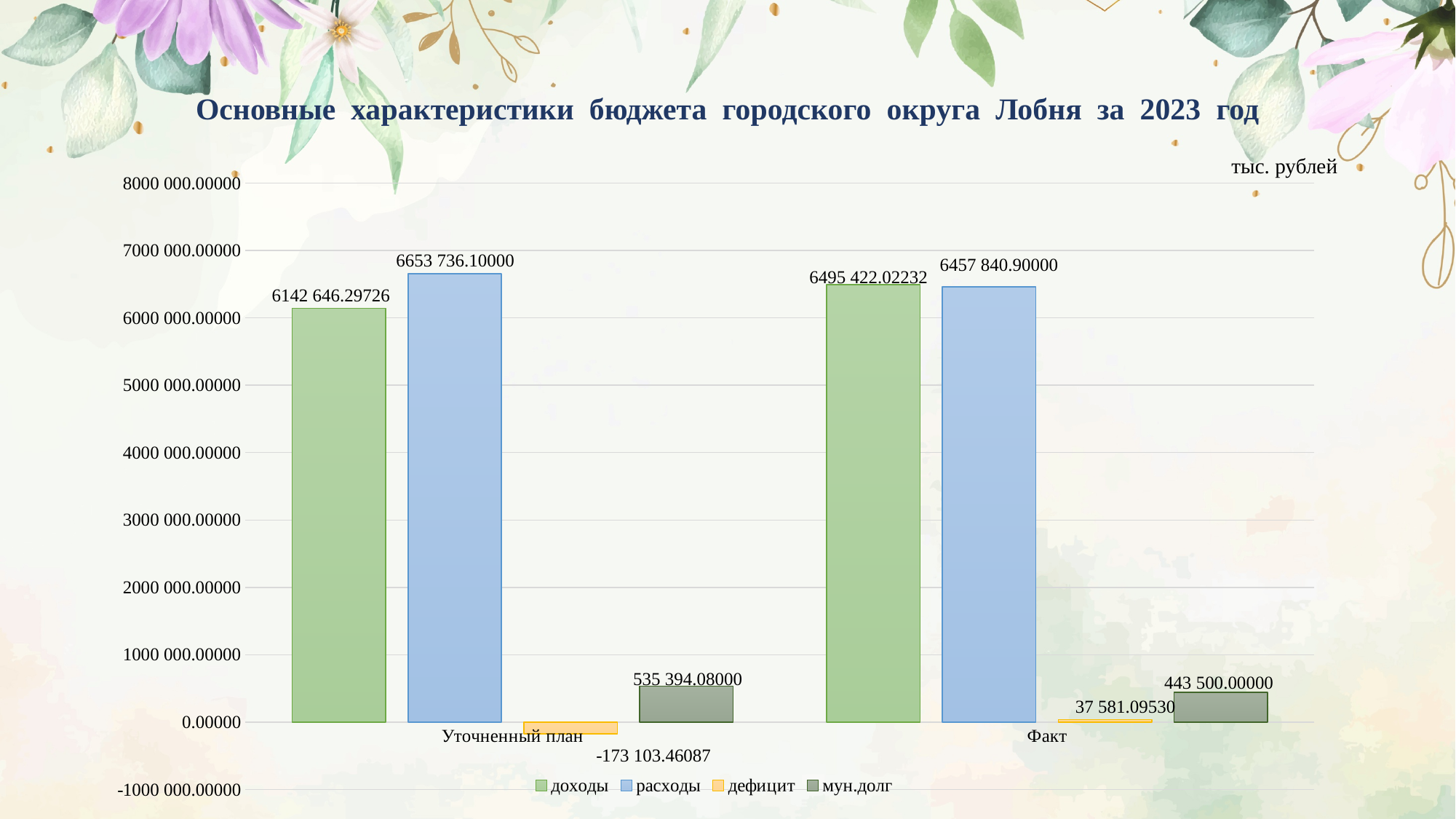
Which series has the lowest value in the Факт category? дефицит What is the value of расходы for Факт? 6457 840.90000 How many series does the legend list? 4 What is the value of дефицит for Уточненный план? -173 103.46087 Which series has the highest value in the Уточненный план category? расходы What kind of chart is shown on the slide? bar chart What unit of measurement is indicated on the chart? тыс. рублей Which is larger: доходы for Факт or доходы for Уточненный план? доходы for Факт What is the value of доходы for Уточненный план? 6142 646.29726 What is the value of мун.долг for Факт? 443 500.00000 What is the difference between мун.долг for Уточненный план and мун.долг for Факт? 91 894.08000 What is the difference between расходы and доходы for Уточненный план? 511 089.80274